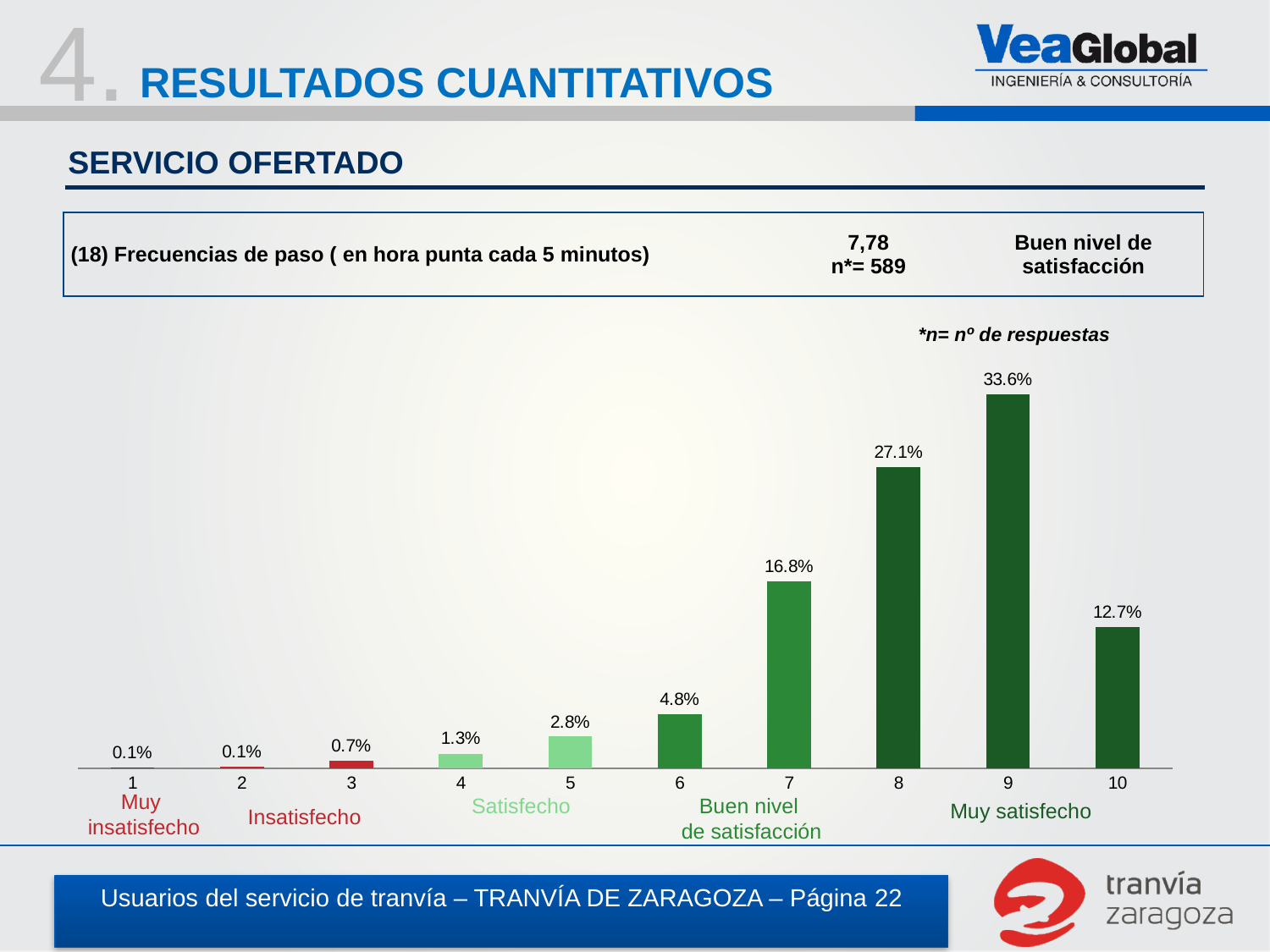
What is the value for category 10? 12.7% Which category has the lowest value among categories 3 to 10? 3 What is the value for category 5? 2.8% What is the difference between the values for category 9 and category 8? 6.5% What is the total of the values for categories 8, 9 and 10? 73.4% What is the value for category 9? 33.6% Which is larger, the value for category 8 or the value for category 10? 8 What kind of chart is shown on the slide? bar chart Which category has the highest value? 9 How many categories are shown on the x axis? 10 What is the difference between the values for category 7 and category 6? 12.0% What is the value for category 7? 16.8%